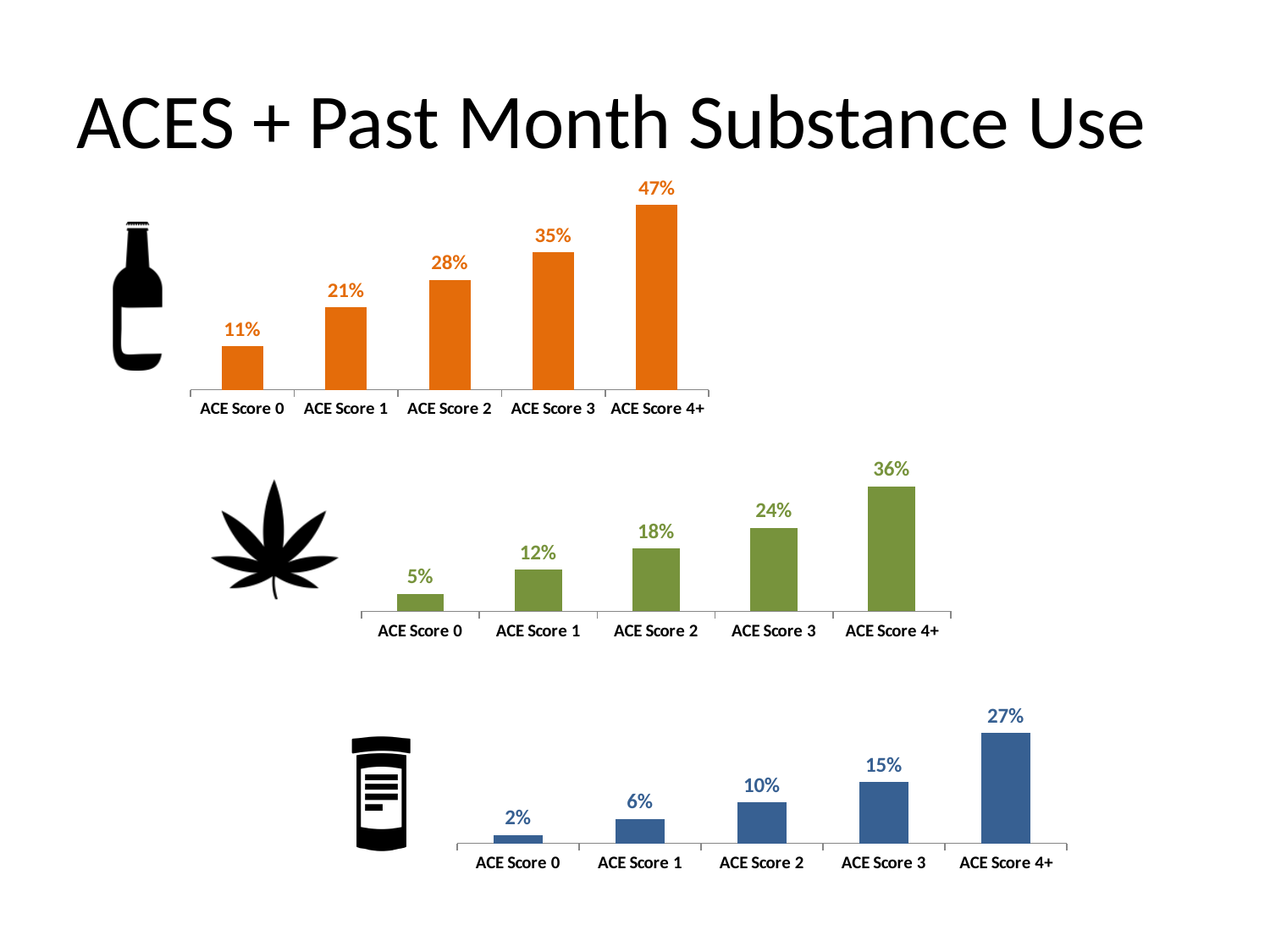
In the top chart (orange bars), what is the difference between the values for ACE Score 3 and ACE Score 1? 14% How many categories are shown in the bottom chart (blue bars)? 5 In the middle chart (green bars), which is larger, the value for ACE Score 1 or ACE Score 3? ACE Score 3 In the middle chart (green bars), do the values rise or fall from ACE Score 0 to ACE Score 4+? Rise In the middle chart (green bars), what is the value for ACE Score 2? 18% In the top chart (orange bars), which category has the lowest value? ACE Score 0 What kind of chart is the top chart (orange bars)? Bar chart In the top chart (orange bars), what is the value for ACE Score 4+? 47% In the bottom chart (blue bars), what is the value for ACE Score 0? 2% What is the title of the slide? ACES + Past Month Substance Use In the bottom chart (blue bars), what is the difference between the values for ACE Score 4+ and ACE Score 0? 25% In the middle chart (green bars), which category has the highest value? ACE Score 4+